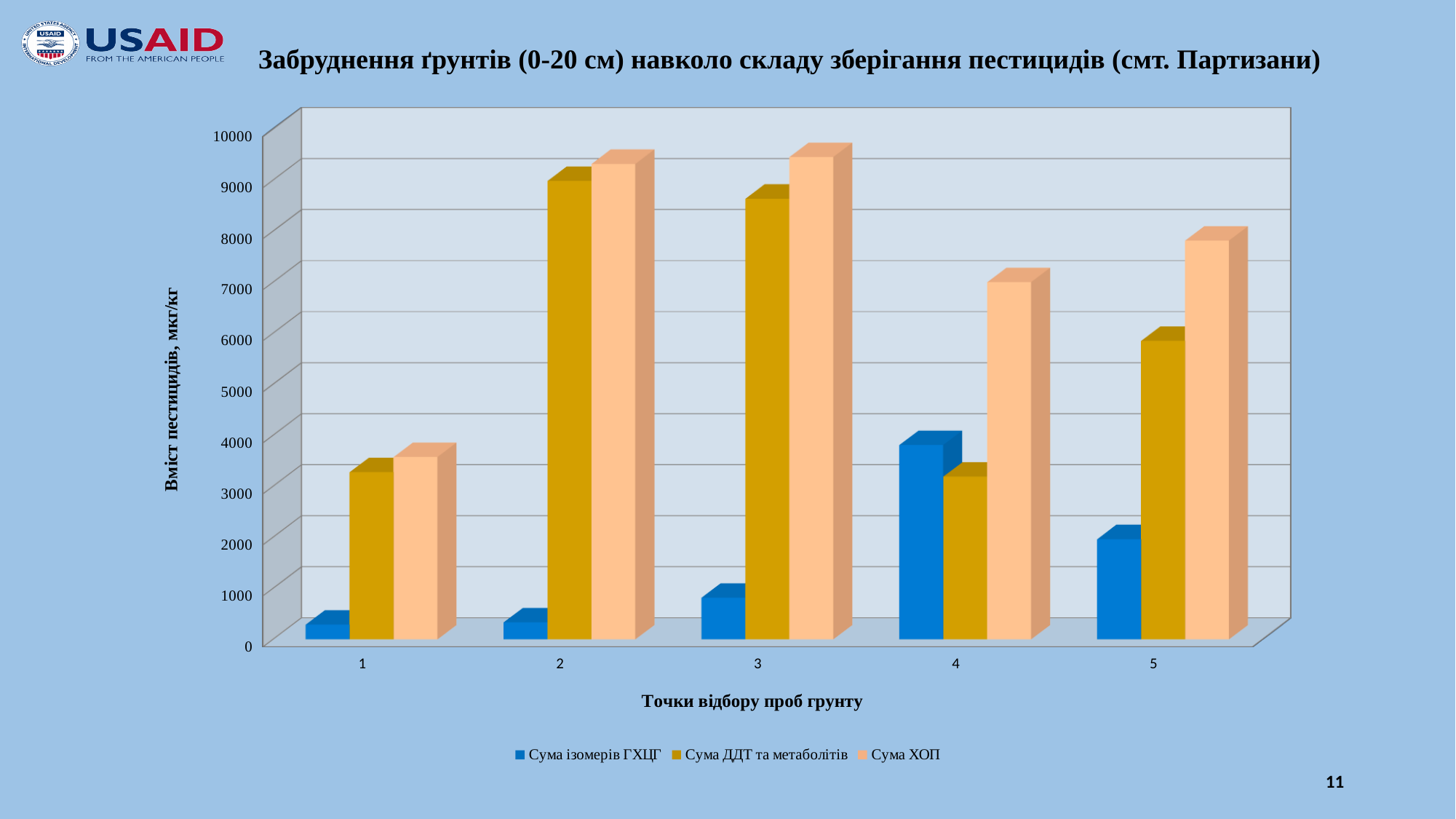
What kind of chart is shown on the slide? bar chart What is the title of the vertical axis? Вміст пестицидів, мкг/кг How many series does the legend list? 3 Is the value for Сума ХОП at sampling point 4 greater or less than 6000? greater How many soil sampling points are shown on the x axis? 5 At sampling point 5, which is larger: Сума ДДТ та метаболітів or Сума ХОП? Сума ХОП At sampling point 1, which is larger: Сума ізомерів ГХЦГ or Сума ДДТ та метаболітів? Сума ДДТ та метаболітів Is the value for Сума ДДТ та метаболітів at sampling point 2 greater or less than 8000? greater At which sampling point is the value for Сума ізомерів ГХЦГ the highest? 4 Is the value for Сума ізомерів ГХЦГ at sampling point 5 greater or less than 3000? less Does the value for Сума ізомерів ГХЦГ rise or fall from sampling point 1 to sampling point 4? rise At which sampling point is the value for Сума ХОП the lowest? 1